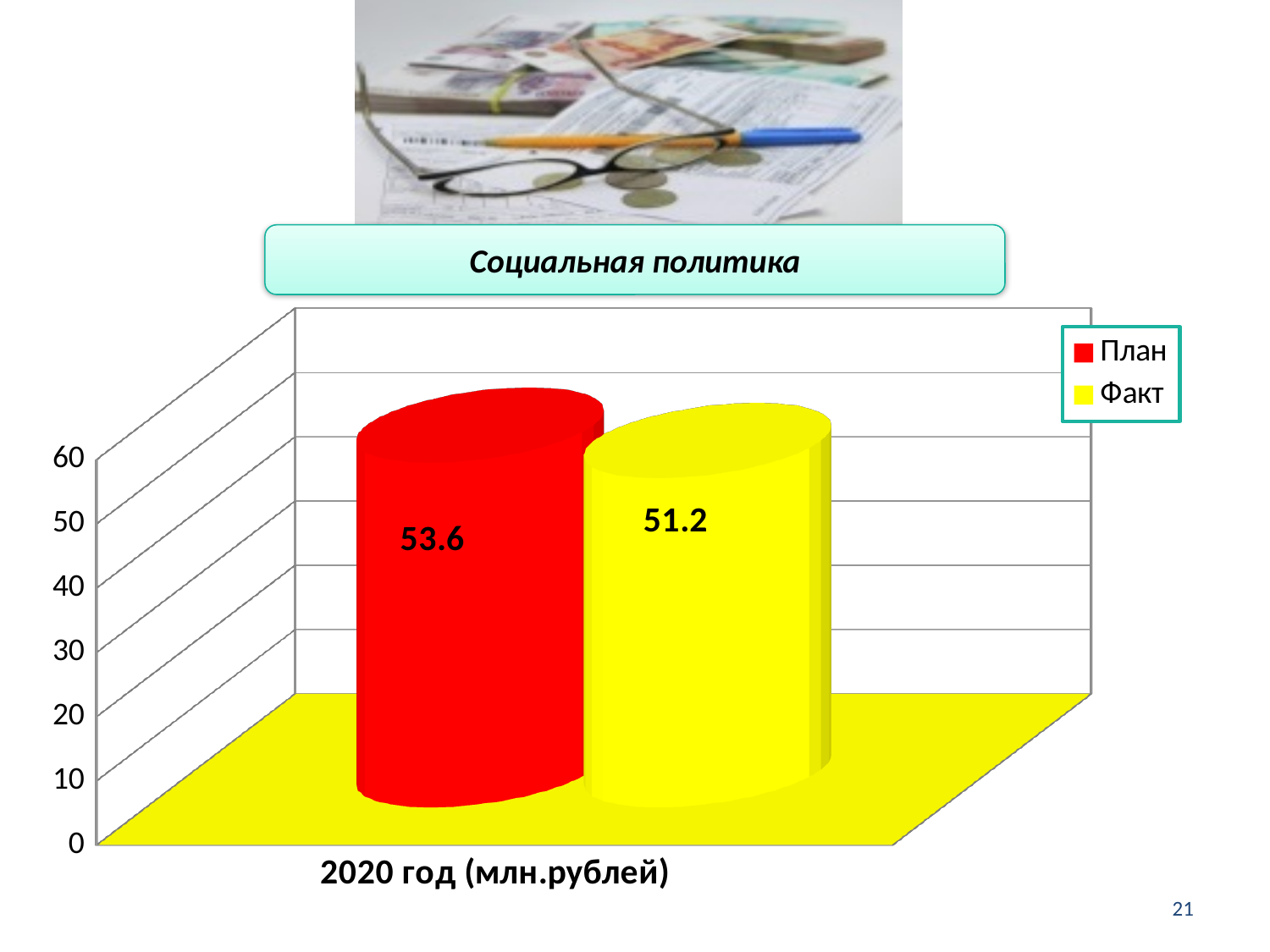
What is the value for План (plan) in 2020? 53.6 Is the value for Факт greater or less than 60? less What kind of chart is shown on the slide? bar chart How many categories are shown on the x axis? 1 Which series has the higher value, План or Факт? План What is the difference between the План and Факт values? 2.4 Which series has the lowest value on the chart? Факт What is the label of the category on the x axis? 2020 год (млн.рублей) What is the value for Факт (actual) in 2020? 51.2 How many series does the legend list? 2 What colour represents the Факт series? yellow